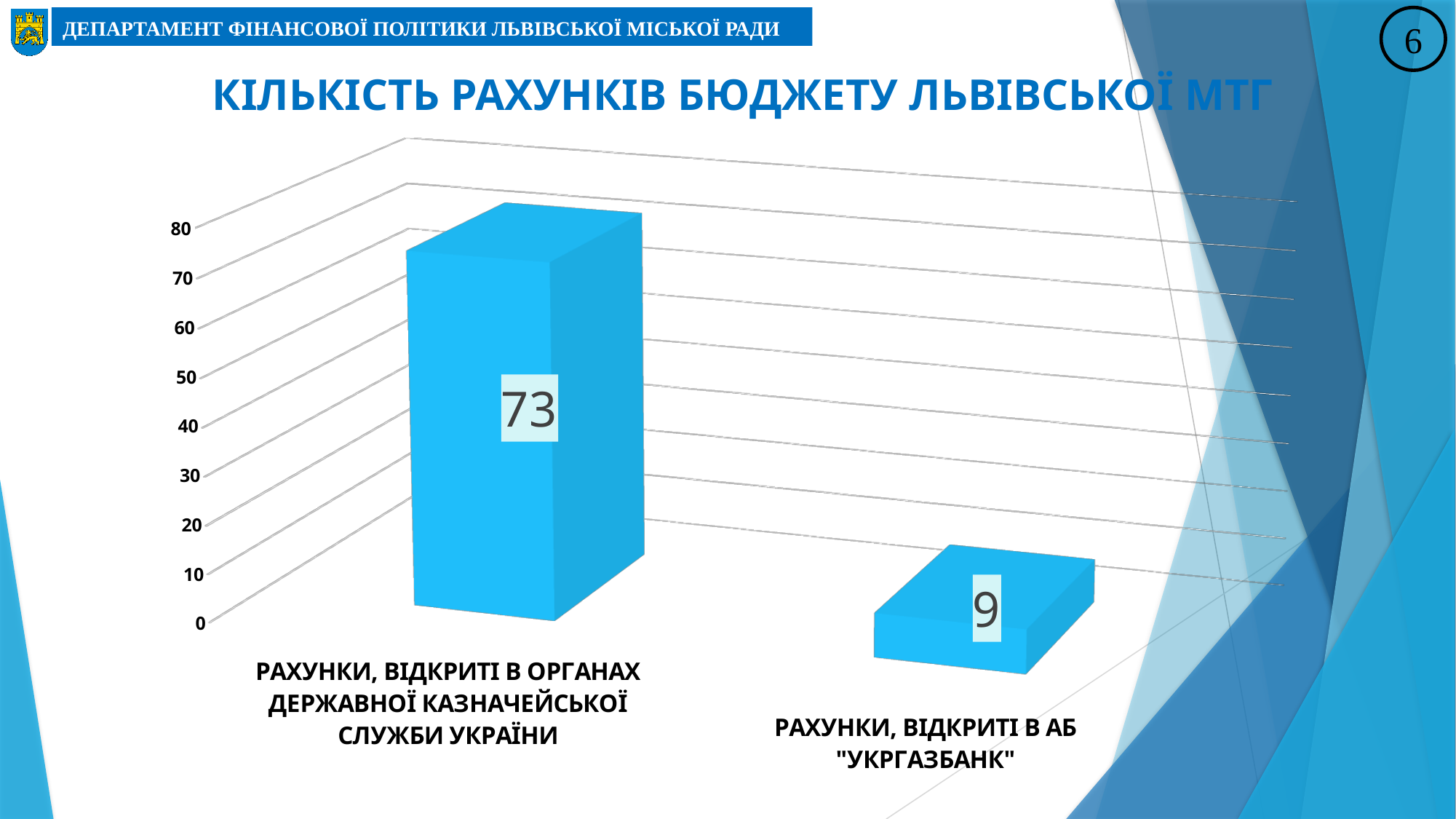
What is the value for РАХУНКИ, ВІДКРИТІ В ОРГАНАХ ДЕРЖАВНОЇ КАЗНАЧЕЙСЬКОЇ СЛУЖБИ УКРАЇНИ? 73 What is the title of the chart? КІЛЬКІСТЬ РАХУНКІВ БЮДЖЕТУ ЛЬВІВСЬКОЇ МТГ What kind of chart is shown on the slide? bar chart What is the maximum value shown on the vertical axis? 80 What is the value for РАХУНКИ, ВІДКРИТІ В АБ "УКРГАЗБАНК"? 9 What is the difference between the value for accounts opened in the State Treasury Service and the value for accounts opened in AB "УКРГАЗБАНК"? 64 How many categories are shown in the chart? 2 Which category has the lowest value? РАХУНКИ, ВІДКРИТІ В АБ "УКРГАЗБАНК" Is the value for РАХУНКИ, ВІДКРИТІ В ОРГАНАХ ДЕРЖАВНОЇ КАЗНАЧЕЙСЬКОЇ СЛУЖБИ УКРАЇНИ greater or less than 70? greater Which category has the highest value? РАХУНКИ, ВІДКРИТІ В ОРГАНАХ ДЕРЖАВНОЇ КАЗНАЧЕЙСЬКОЇ СЛУЖБИ УКРАЇНИ Which is larger: the value for РАХУНКИ, ВІДКРИТІ В ОРГАНАХ ДЕРЖАВНОЇ КАЗНАЧЕЙСЬКОЇ СЛУЖБИ УКРАЇНИ or the value for РАХУНКИ, ВІДКРИТІ В АБ "УКРГАЗБАНК"? РАХУНКИ, ВІДКРИТІ В ОРГАНАХ ДЕРЖАВНОЇ КАЗНАЧЕЙСЬКОЇ СЛУЖБИ УКРАЇНИ Is the value for РАХУНКИ, ВІДКРИТІ В АБ "УКРГАЗБАНК" greater or less than 10? less